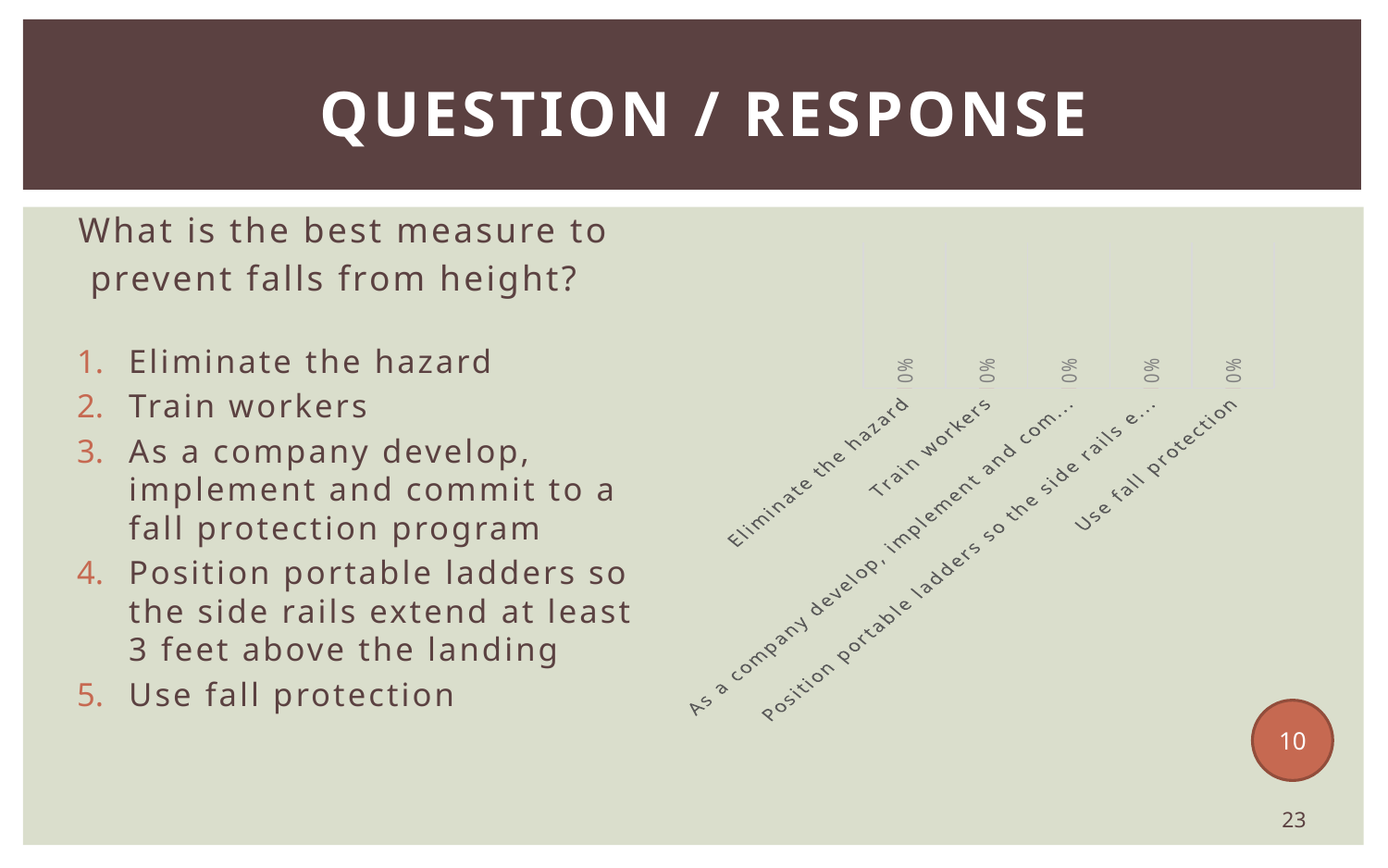
Which category label appears first (leftmost) on the chart's x axis? Eliminate the hazard How many categories are shown on the chart? 5 What value is shown for "Eliminate the hazard"? 0% What kind of chart is shown on the slide? bar chart What is the difference between the values for "Eliminate the hazard" and "Use fall protection"? 0% What value is shown for "Use fall protection"? 0% What value is shown for the category beginning "As a company develop, implement and com..."? 0% What value is shown for "Train workers"? 0% What value is shown for the category beginning "Position portable ladders so the side rails e..."? 0% Which category label appears last (rightmost) on the chart's x axis? Use fall protection Do the values on the chart rise, fall, or stay the same across the categories? stay the same